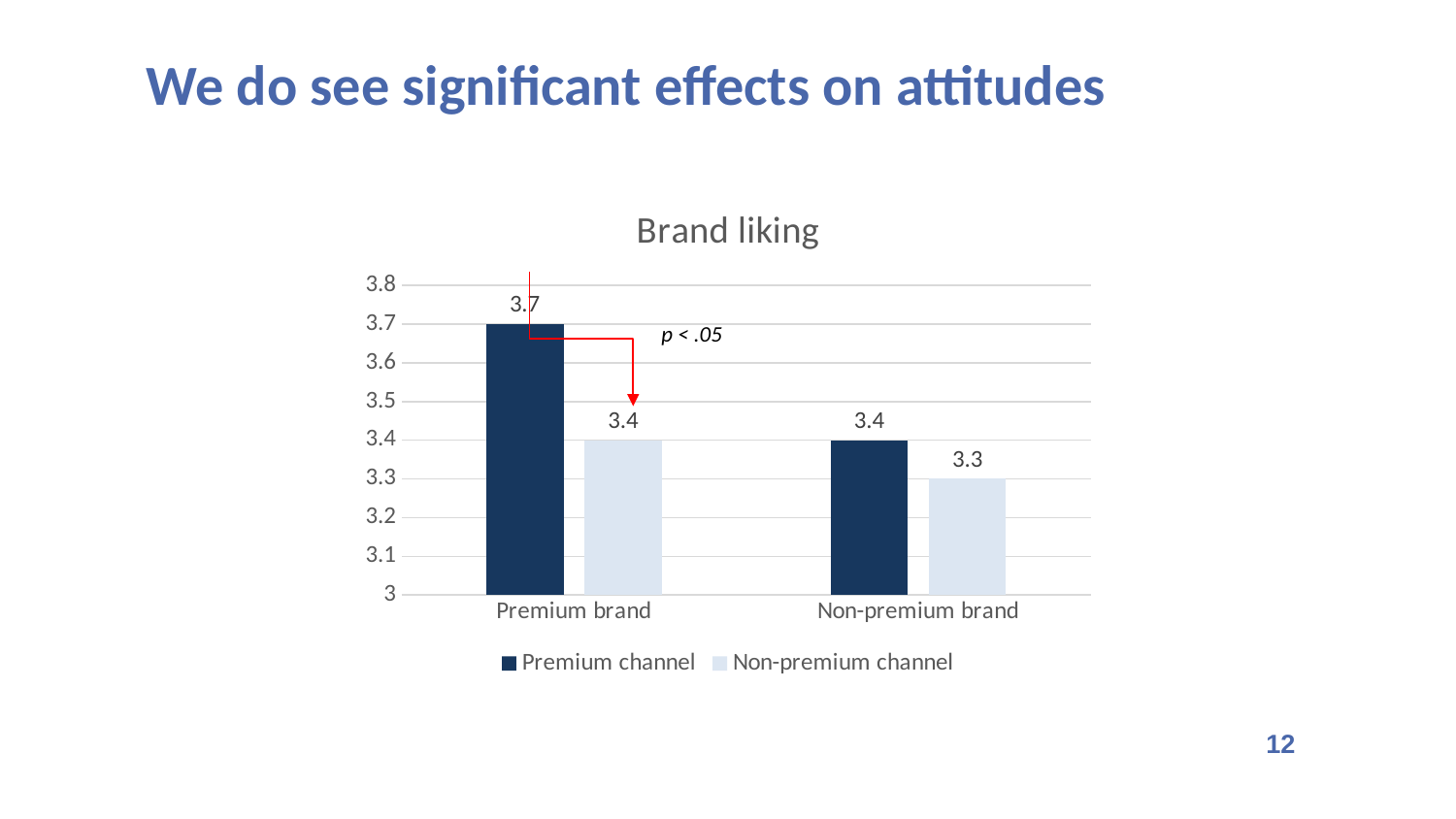
How many series does the legend list? 2 Which bar has the lowest brand liking value? Non-premium brand, Non-premium channel What is the difference in brand liking between the Premium channel and Non-premium channel for Premium brand? 0.3 What is the brand liking value for Premium brand in the Non-premium channel? 3.4 Which bar has the highest brand liking value? Premium brand, Premium channel What is the brand liking value for Non-premium brand in the Non-premium channel? 3.3 What is the brand liking value for Non-premium brand in the Premium channel? 3.4 For Non-premium brand, which channel has the higher brand liking value? Premium channel How many brand categories are shown on the x axis? 2 What kind of chart is shown on the slide? Bar chart What is the brand liking value for Premium brand in the Premium channel? 3.7 What is the title of the chart? Brand liking